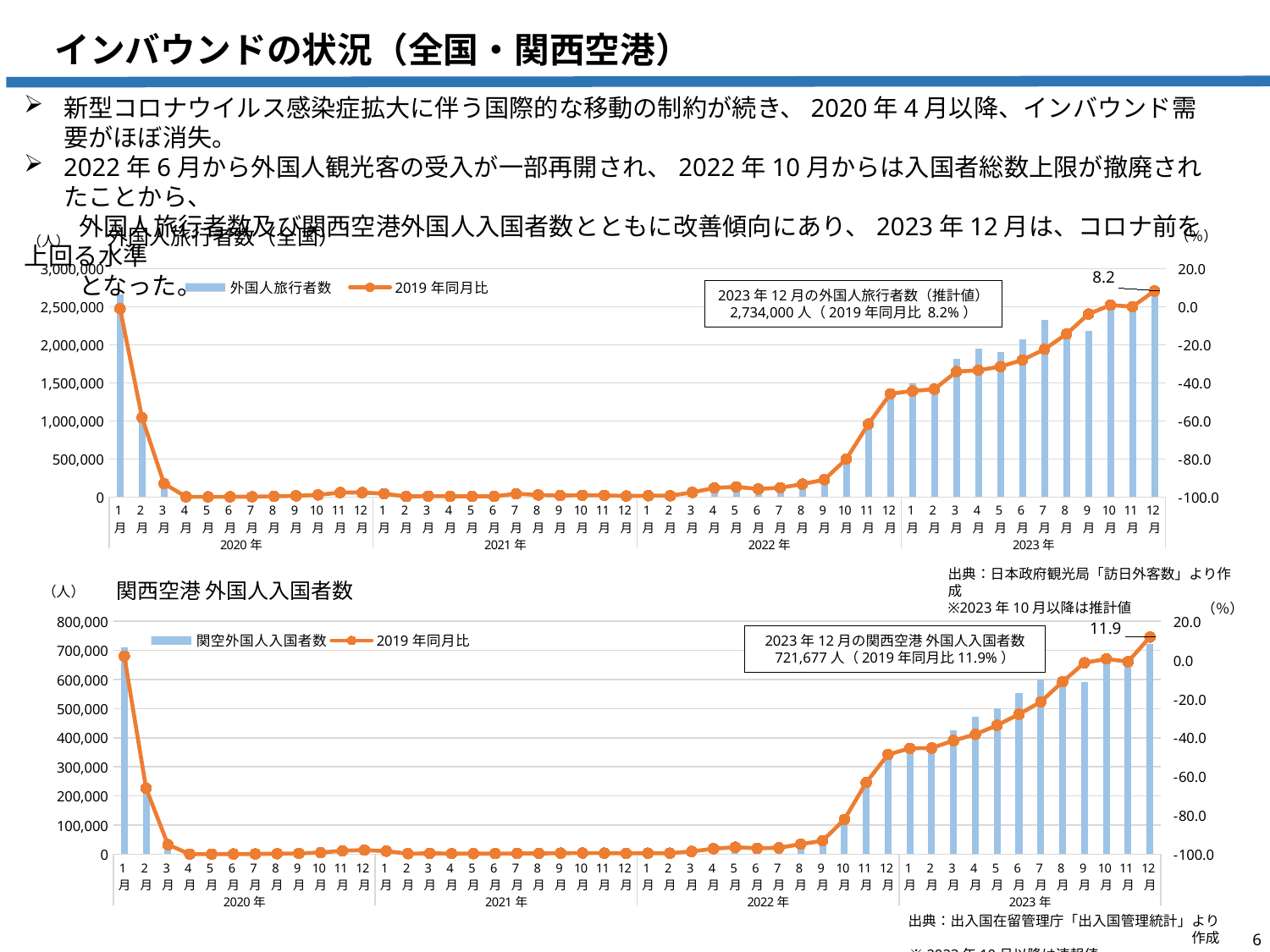
How many series does the legend of the top chart (外国人旅行者数（全国）) list? 2 In the top chart (外国人旅行者数（全国）), what is the number of foreign travellers for December 2023 given in the annotation box? 2,734,000人 In the bottom chart (関西空港 外国人入国者数), what is the number of foreign entrants at Kansai Airport for December 2023 given in the annotation box? 721,677人 In the top chart (外国人旅行者数（全国）), which bar is larger: January 2020 or April 2020? January 2020 What are the two legend entries in the bottom chart (関西空港 外国人入国者数)? 関空外国人入国者数, 2019年同月比 In the bottom chart (関西空港 外国人入国者数), is the bar for January 2020 greater or less than 600,000? greater In the top chart (外国人旅行者数（全国）), is the bar for April 2020 greater or less than 500,000? less In the top chart (外国人旅行者数（全国）), what is the 2019年同月比 value labelled for December 2023? 8.2 In the bottom chart (関西空港 外国人入国者数), do the bars rise or fall from January 2023 to December 2023? rise In the top chart (外国人旅行者数（全国）), is the bar for January 2020 greater or less than 2,500,000? greater In the bottom chart (関西空港 外国人入国者数), what is the 2019年同月比 value labelled for December 2023? 11.9 What kind of chart is the top chart (外国人旅行者数（全国）)? Combination bar and line chart